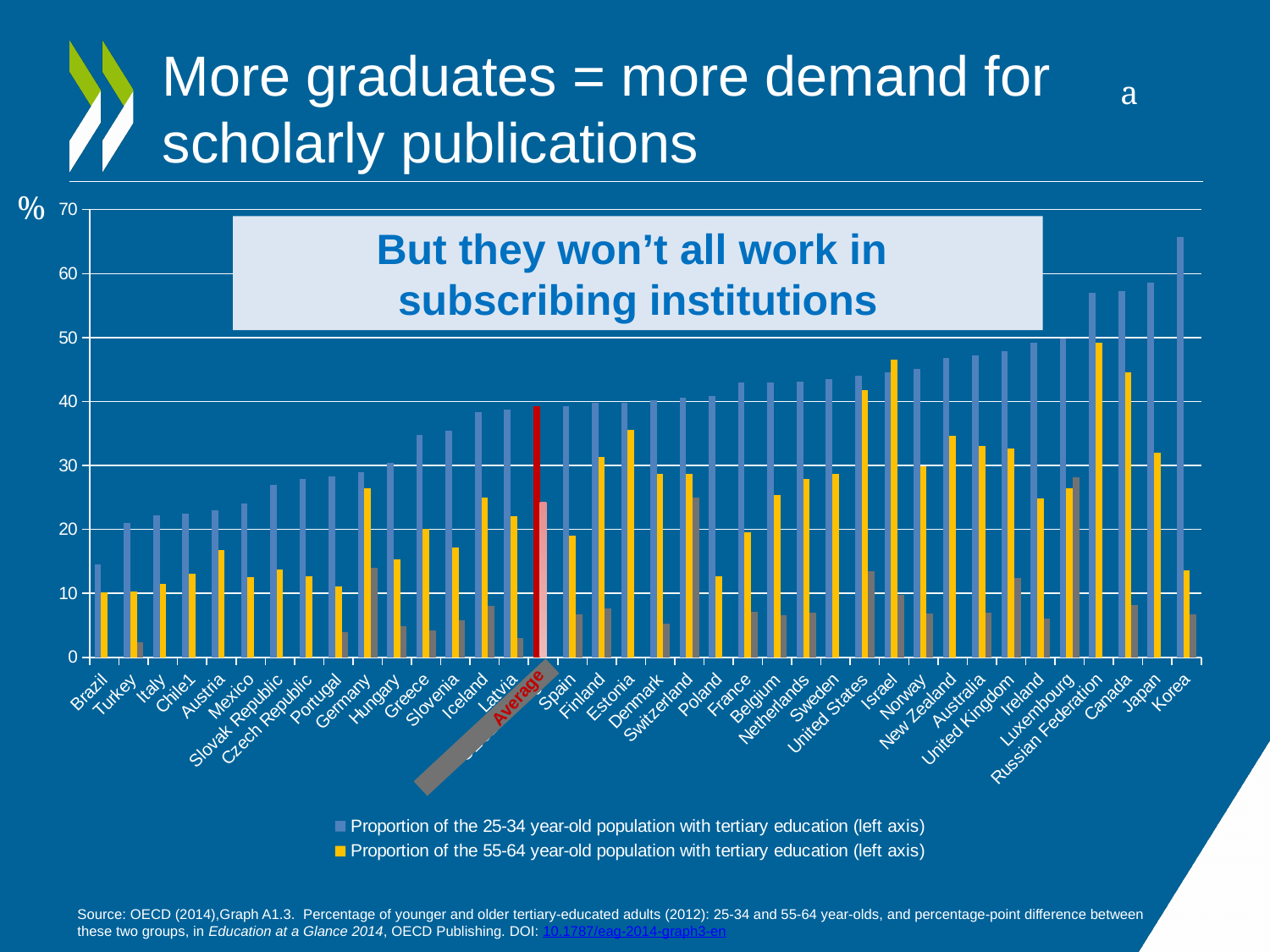
What kind of chart is shown on the slide? bar chart Is the proportion of the 25-34 year-old population with tertiary education for Korea greater or less than 60? greater Do the values for the 25-34 year-old population with tertiary education generally rise or fall from left to right along the x axis? rise Which has a higher proportion of the 55-64 year-old population with tertiary education, Israel or Korea? Israel Which has a higher proportion of the 25-34 year-old population with tertiary education, Korea or Japan? Korea Is the proportion of the 25-34 year-old population with tertiary education for Brazil greater or less than 20? less Which country has the lowest proportion of the 25-34 year-old population with tertiary education? Brazil What colour is the bar for the Average category? red Which country has the highest proportion of the 25-34 year-old population with tertiary education? Korea Is the proportion of the 55-64 year-old population with tertiary education for Israel greater or less than 40? greater How many series does the legend list? 2